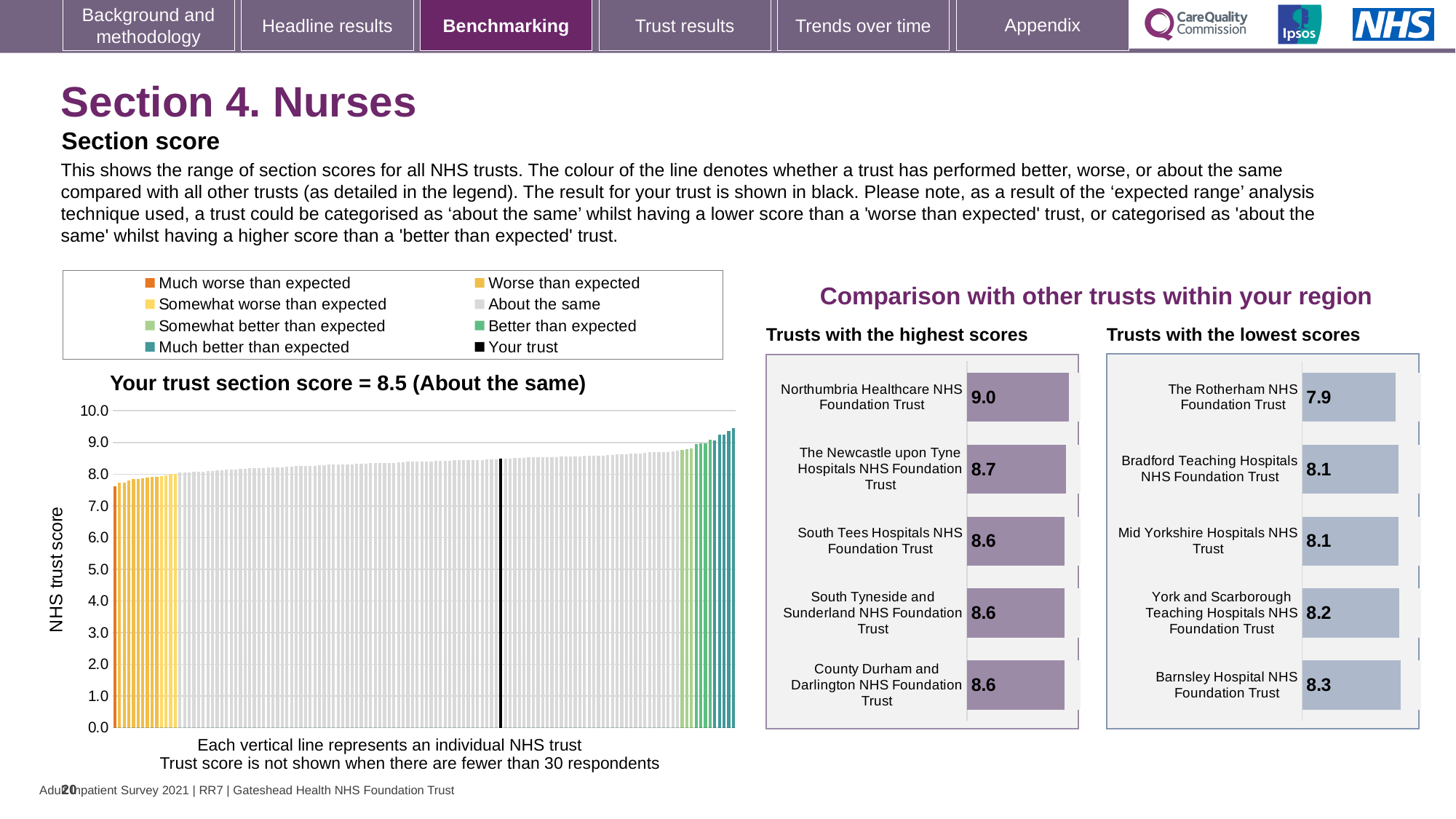
In the main chart on the left, is the value of the lowest (leftmost) bar greater or less than 8.0? less In the 'Trusts with the lowest scores' chart, what is the score for The Rotherham NHS Foundation Trust? 7.9 In the 'Trusts with the highest scores' chart, what is the score for Northumbria Healthcare NHS Foundation Trust? 9.0 In the 'Trusts with the lowest scores' chart, which trust has the lowest score? The Rotherham NHS Foundation Trust How many trusts are listed in the 'Trusts with the lowest scores' chart? 5 In the 'Trusts with the highest scores' chart, which has the larger score: Northumbria Healthcare NHS Foundation Trust or The Newcastle upon Tyne Hospitals NHS Foundation Trust? Northumbria Healthcare NHS Foundation Trust In the 'Trusts with the highest scores' chart, what is the score for The Newcastle upon Tyne Hospitals NHS Foundation Trust? 8.7 In the 'Trusts with the lowest scores' chart, what is the score for Barnsley Hospital NHS Foundation Trust? 8.3 In the 'Trusts with the highest scores' chart, which trust has the highest score? Northumbria Healthcare NHS Foundation Trust According to the title of the main chart on the left, what is your trust's section score? 8.5 How many entries does the legend of the main chart on the left list? 8 What is the difference between the score for Northumbria Healthcare NHS Foundation Trust in the highest scores chart and the score for The Rotherham NHS Foundation Trust in the lowest scores chart? 1.1